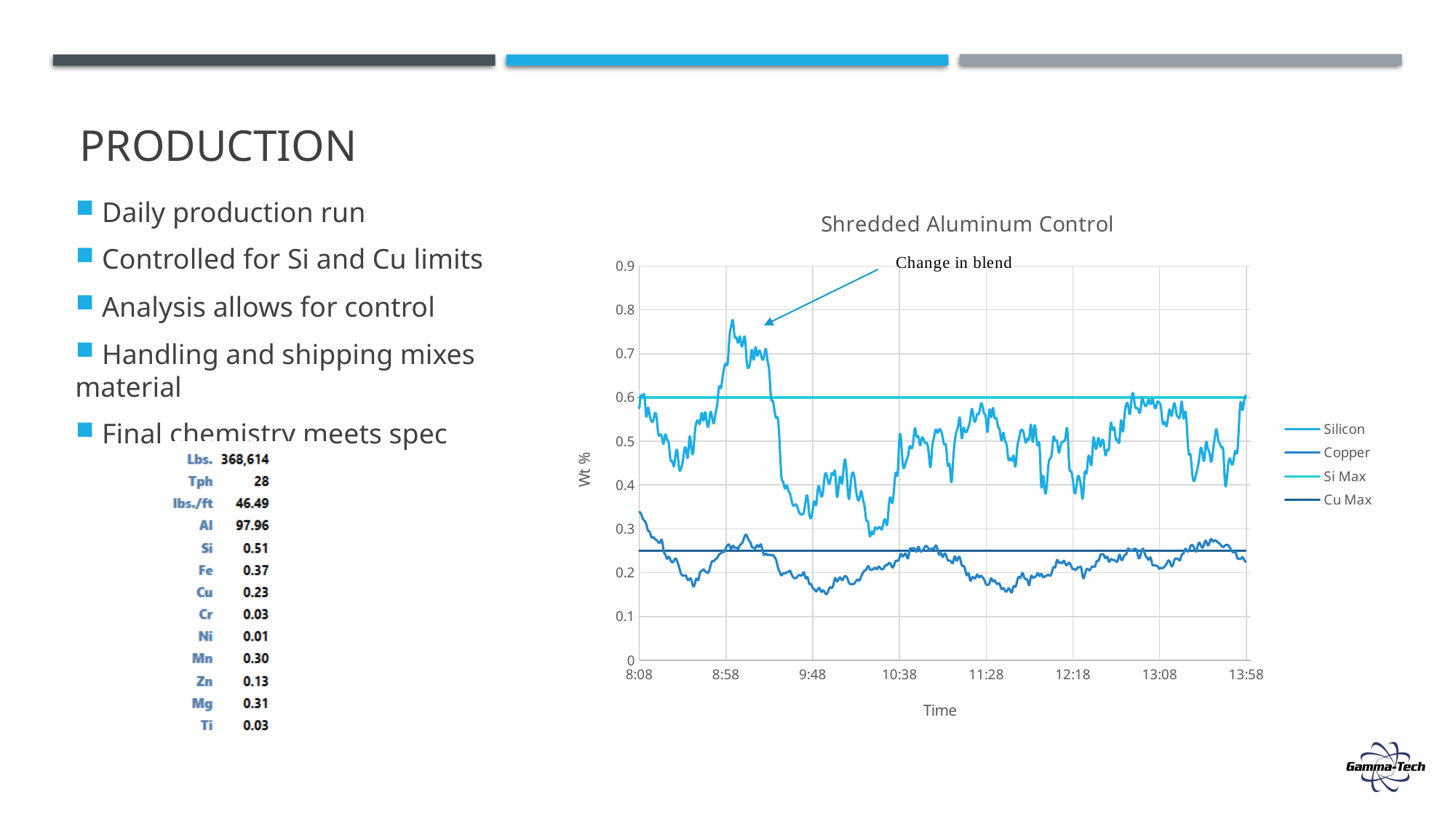
Is the lowest Copper value near 9:48 greater or less than 0.2? less Is the Copper value at 8:08 greater or less than 0.3? greater What is the value of the Si Max line? 0.6 What does the annotation with the arrow on the chart say? Change in blend How many series does the chart legend list? 4 Is the peak value of the Silicon series shortly after 8:58 greater or less than 0.7? greater What type of chart is shown on the slide? Line chart How many time labels are shown on the x axis? 8 What is the title of the chart? Shredded Aluminum Control Which series has higher values throughout the chart, Silicon or Copper? Silicon